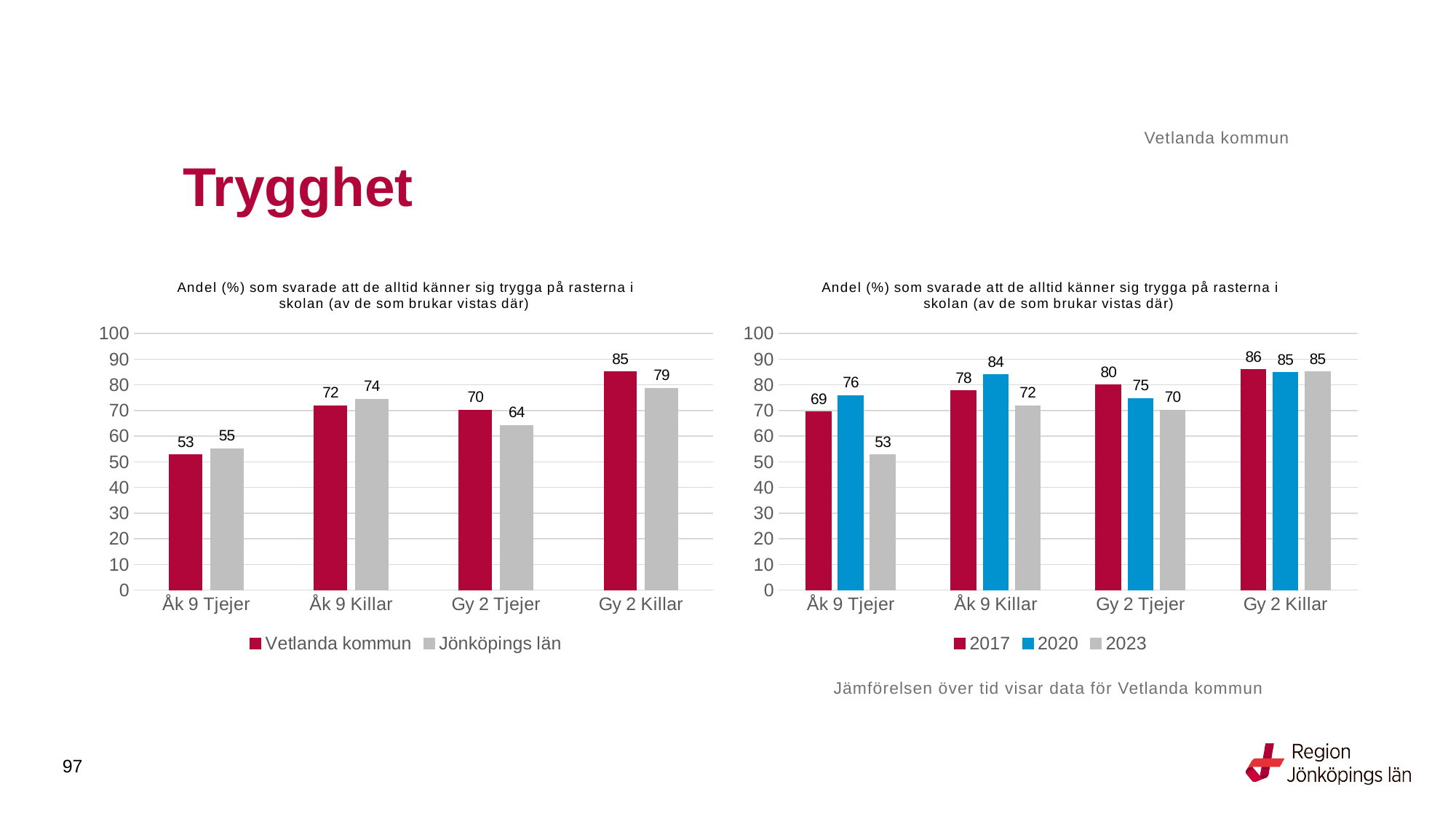
In the right chart, what is the difference between the 2017 and 2023 values for Åk 9 Tjejer? 16 In the left chart, which category has the highest value for Vetlanda kommun? Gy 2 Killar In the left chart, which is larger for Åk 9 Killar: Vetlanda kommun or Jönköpings län? Jönköpings län In the right chart, what is the value for 2023 for Åk 9 Tjejer? 53 In the right chart, how many categories are shown on the x axis? 4 In the left chart, what is the value for Vetlanda kommun for Åk 9 Tjejer? 53 In the right chart, how many series does the legend list? 3 In the left chart, what is the value for Jönköpings län for Gy 2 Killar? 79 In the right chart, what is the value for 2020 for Åk 9 Killar? 84 In the left chart, which category has the lowest value for Jönköpings län? Åk 9 Tjejer In the left chart, what is the difference between Vetlanda kommun and Jönköpings län for Gy 2 Tjejer? 6 What kind of chart is the left chart? Bar chart